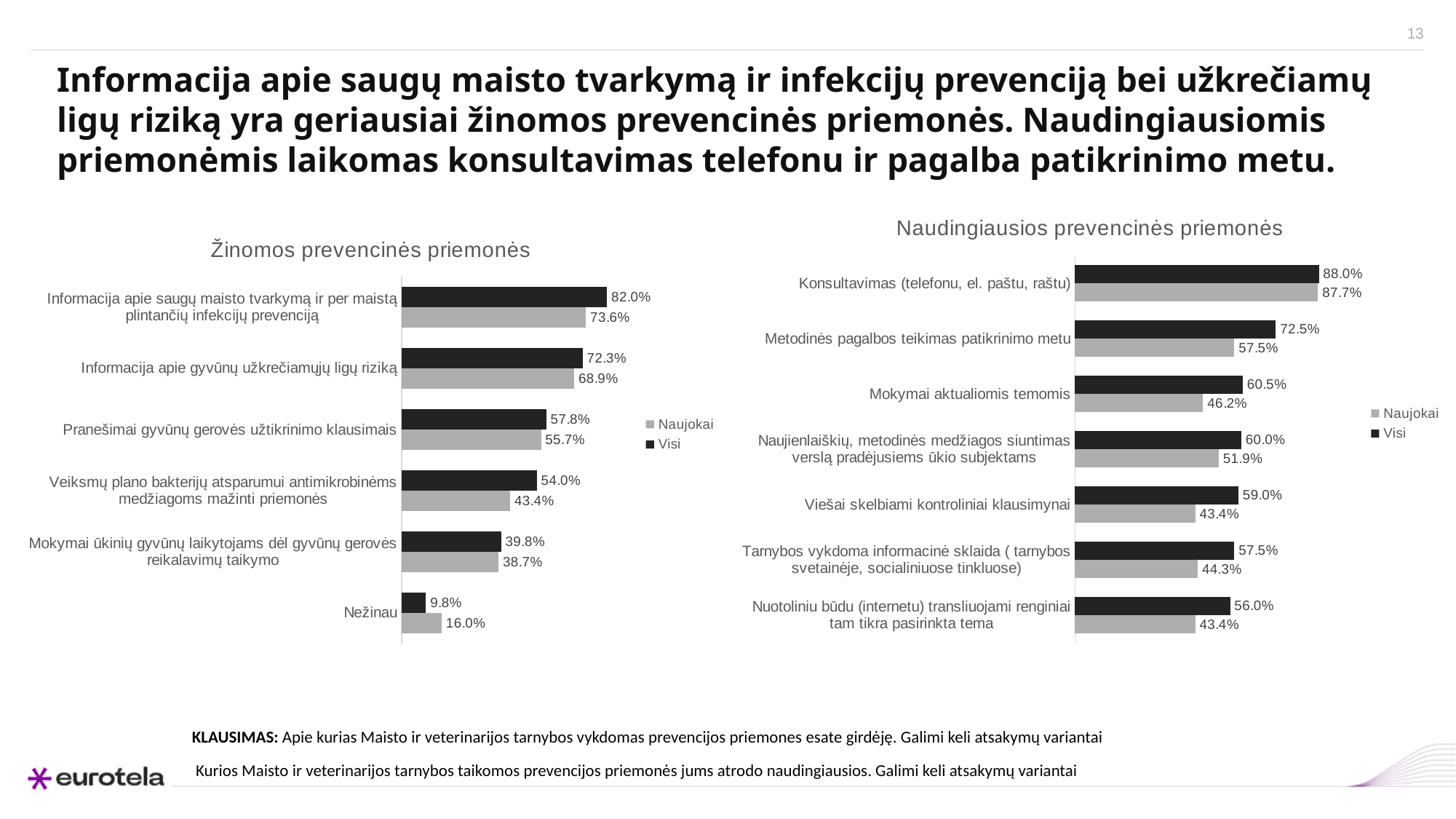
In the chart 'Naudingiausios prevencinės priemonės', what is the difference between the Visi and Naujokai values for 'Metodinės pagalbos teikimas patikrinimo metu'? 15.0% In the chart 'Žinomos prevencinės priemonės', what is the difference between the Visi and Naujokai values for 'Veiksmų plano bakterijų atsparumui antimikrobinėms medžiagoms mažinti priemonės'? 10.6% In the chart 'Naudingiausios prevencinės priemonės', how many series does the legend list? 2 In the chart 'Naudingiausios prevencinės priemonės', which category has the lowest Visi value? Nuotoliniu būdu (internetu) transliuojami renginiai tam tikra pasirinkta tema In the chart 'Žinomos prevencinės priemonės', what is the Visi value for 'Informacija apie gyvūnų užkrečiamųjų ligų riziką'? 72.3% In the chart 'Naudingiausios prevencinės priemonės', what is the Visi value for 'Viešai skelbiami kontroliniai klausimynai'? 59.0% What type of chart is 'Naudingiausios prevencinės priemonės'? Bar chart In the chart 'Žinomos prevencinės priemonės', for 'Nežinau', which series has the larger value, Naujokai or Visi? Naujokai In the chart 'Žinomos prevencinės priemonės', how many categories are shown? 6 In the chart 'Žinomos prevencinės priemonės', which category has the highest Visi value? Informacija apie saugų maisto tvarkymą ir per maistą plintančių infekcijų prevenciją In the chart 'Naudingiausios prevencinės priemonės', what is the Naujokai value for 'Mokymai aktualiomis temomis'? 46.2% In the chart 'Žinomos prevencinės priemonės', what is the Naujokai value for 'Nežinau'? 16.0%